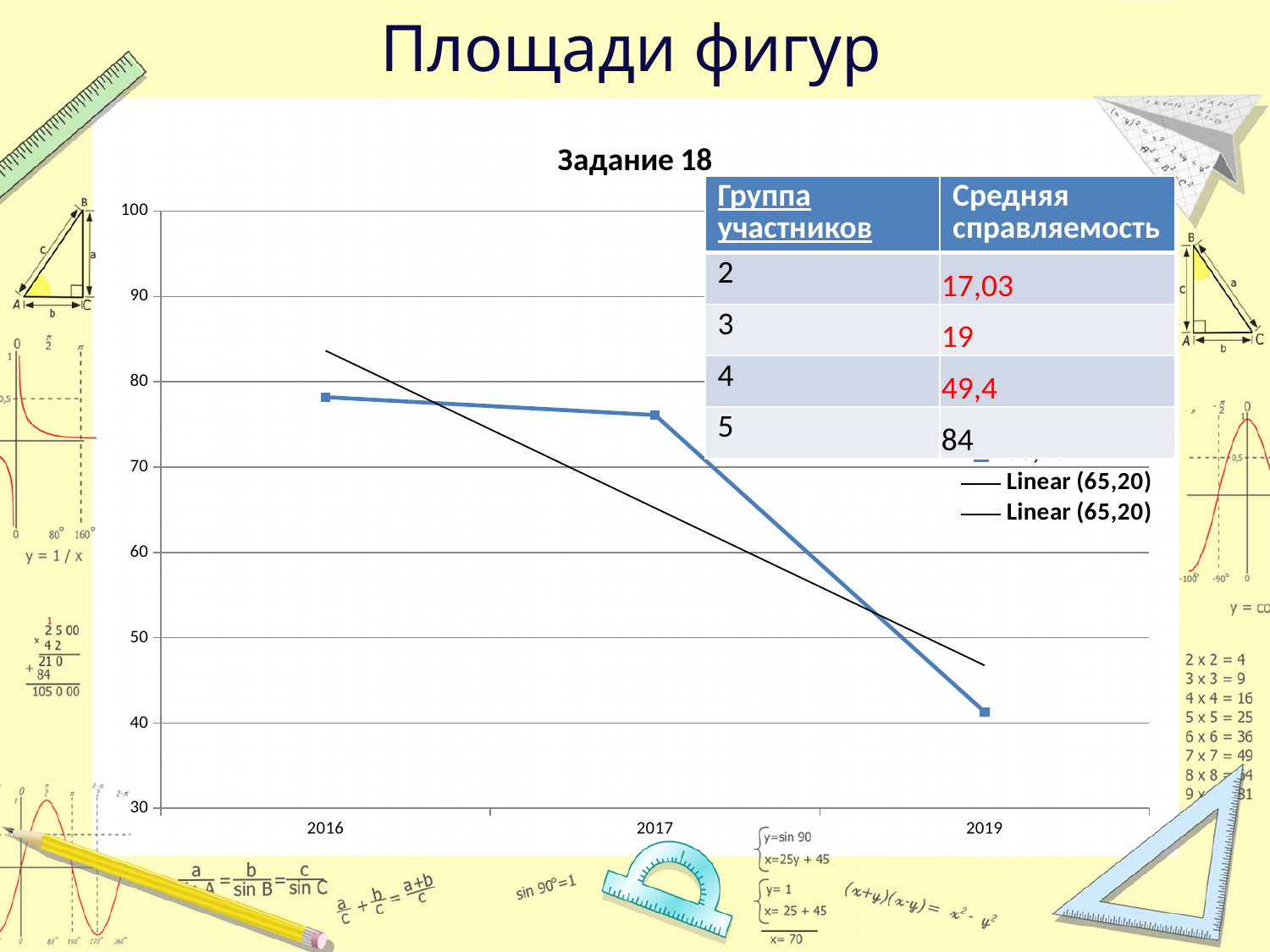
What is the title of the chart? Задание 18 Is the value for 2019 greater or less than 50? less Is the value for 2019 greater or less than 40? greater Which is larger, the value for 2016 or the value for 2019? 2016 Do the values on the blue line rise or fall from 2016 to 2019? fall Is the value for 2016 greater or less than 70? greater How many data points are plotted on the blue line? 3 What label is shown for the black trendline in the legend? Linear (65,20) What kind of chart is shown on the slide? line chart Which year has the lowest value on the blue line? 2019